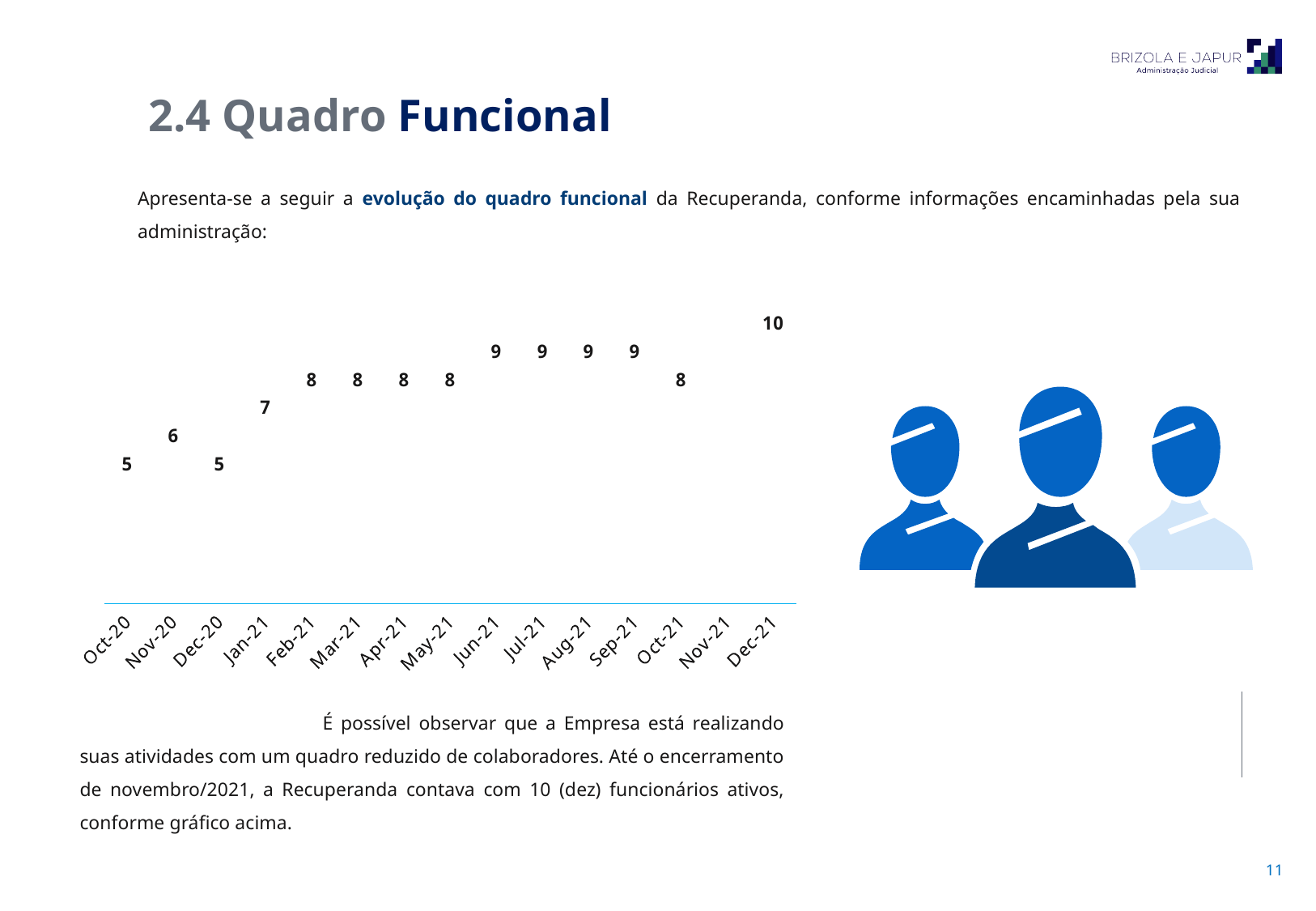
What is the value shown for Jun-21? 9 Which has the larger value, Nov-20 or Dec-20? Nov-20 What is the value shown for Oct-20? 5 How many months are labelled on the x axis of the chart? 15 What is the value shown for Oct-21? 8 What is the difference between the values for Jan-21 and Oct-20? 2 Do the values generally rise or fall from Oct-20 to Sep-21? rise What is the value shown for Nov-20? 6 What is the highest value labelled on the chart? 10 What is the value shown for Jan-21? 7 What is the value shown for Feb-21? 8 What is the difference between the values for Sep-21 and Oct-21? 1